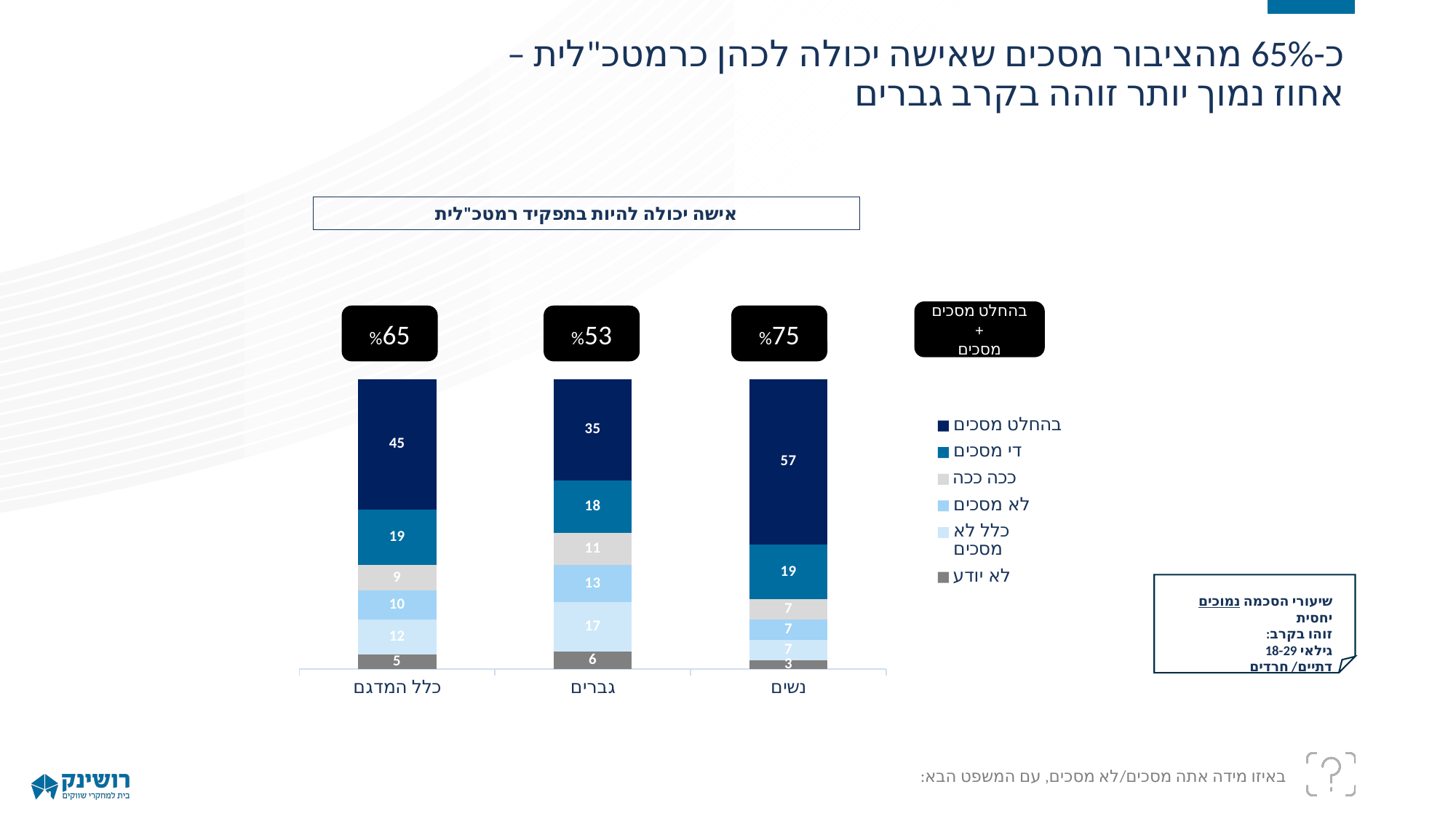
Which is larger: the לא מסכים value for גברים or for נשים? גברים What is the value of בהחלט מסכים for גברים? 35 What type of chart is shown on the slide? stacked bar chart What is the difference between the בהחלט מסכים values for נשים and גברים? 22 What is the combined percentage (בהחלט מסכים + מסכים) shown above the bar for גברים? 53% How many categories are shown on the x axis of the chart? 3 Which category has the highest value for בהחלט מסכים? נשים What is the value of בהחלט מסכים for נשים? 57 How many series does the chart legend list? 6 What is the title shown in the box above the chart? אישה יכולה להיות בתפקיד רמטכ"לית Which category has the lowest value for לא יודע? נשים What is the value of כלל לא מסכים for כלל המדגם? 12